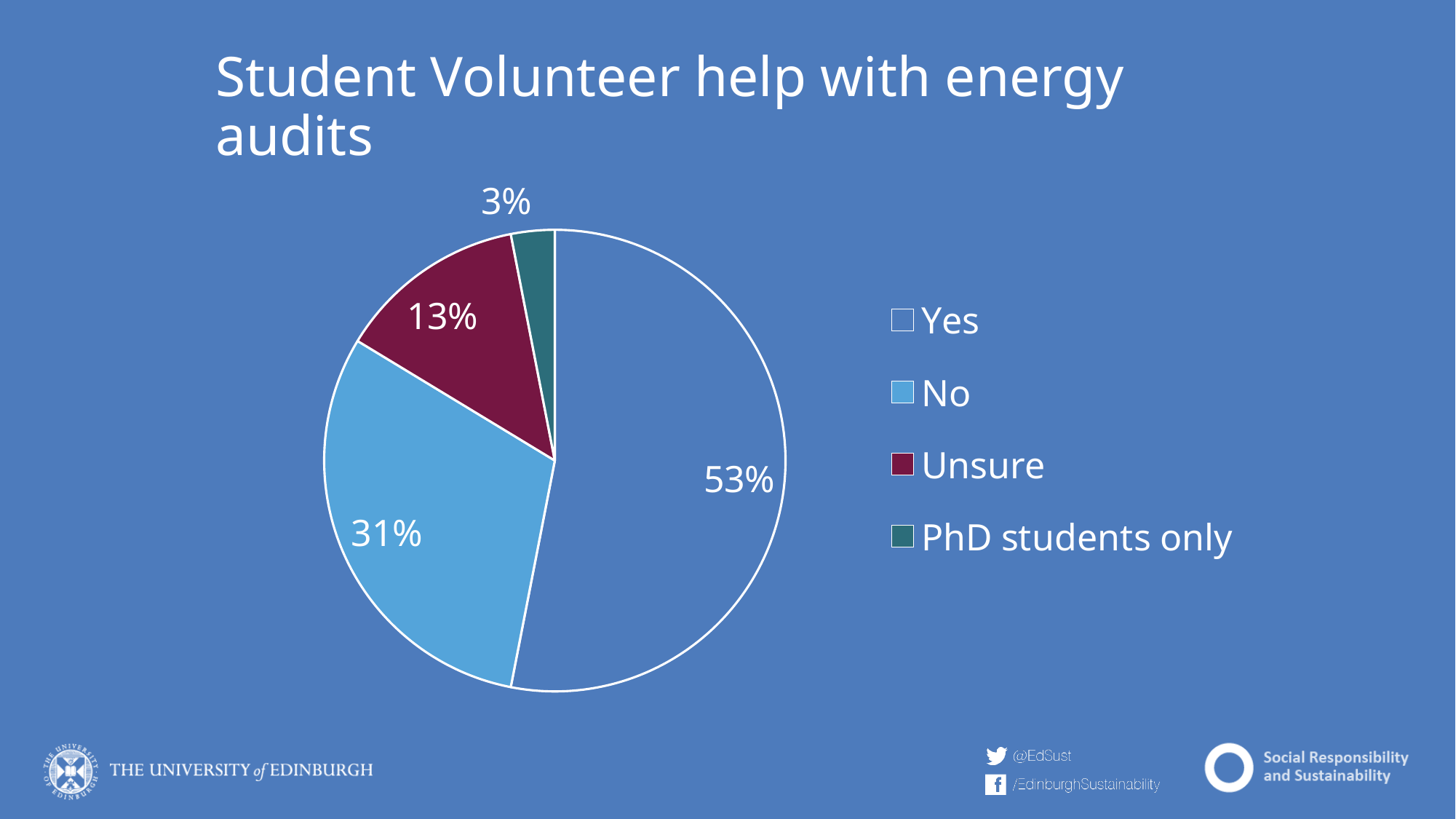
What percentage of the pie chart is labelled "Unsure"? 13% Which slice is larger, "Unsure" or "PhD students only"? Unsure What is the title of the chart on the slide? Student Volunteer help with energy audits What is the difference in percentage points between the "Yes" and "No" slices? 22 What percentage of the pie chart is labelled "Yes"? 53% How many categories does the pie chart show? 4 Which category has the largest slice of the pie chart? Yes What colour is the "Unsure" slice in the pie chart? Dark red What percentage of the pie chart is labelled "No"? 31% What kind of chart is shown on the slide? Pie chart Which category has the smallest slice of the pie chart? PhD students only What percentage of the pie chart is labelled "PhD students only"? 3%